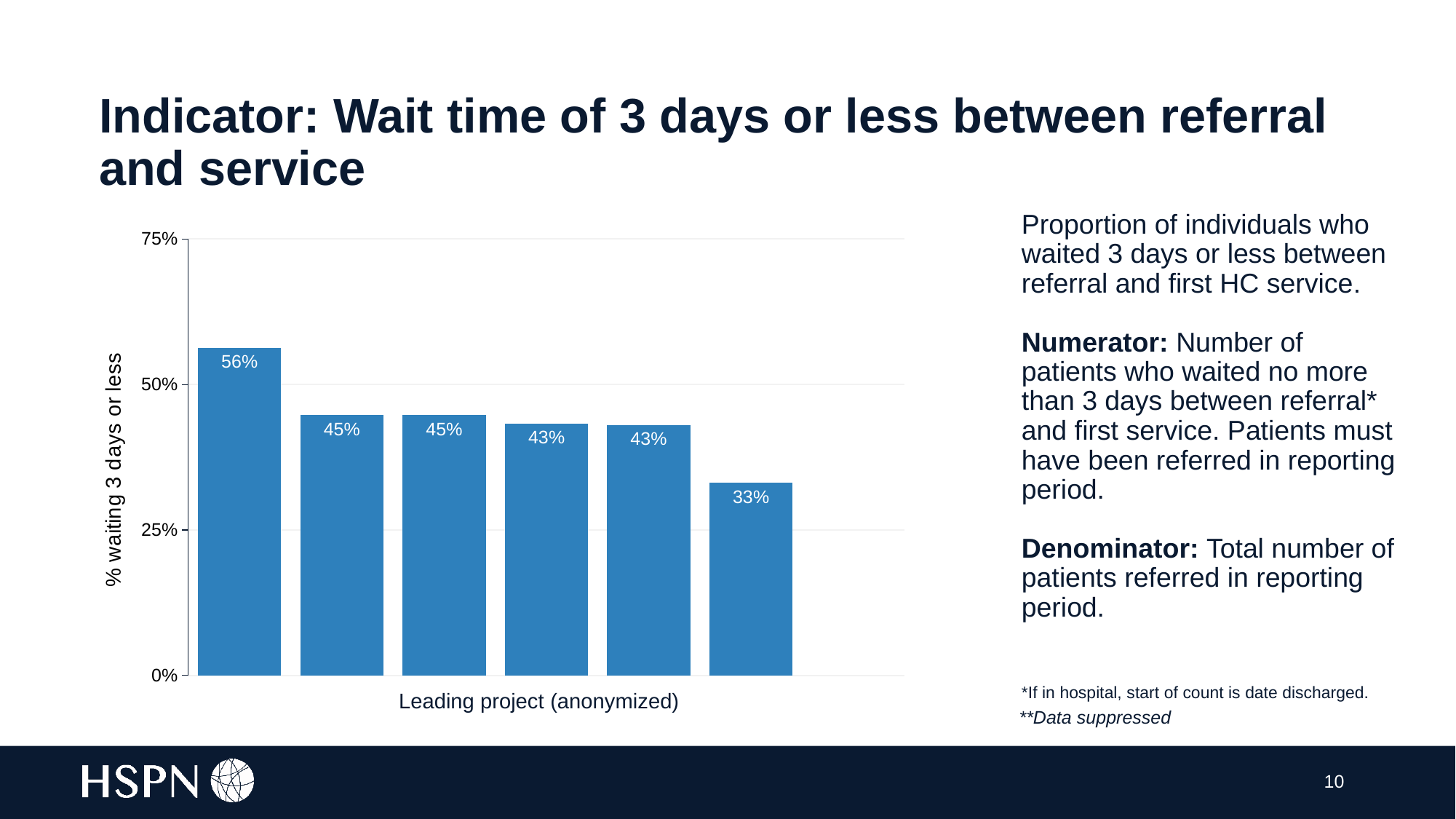
What is the value of the fourth bar from the left? 43% Do the bar values rise or fall from left to right across the chart? Fall What is the lowest value shown in the chart? 33% What is the value of the leftmost bar in the chart? 56% Is the value of the leftmost bar greater or less than 50%? greater What is the highest value shown in the chart? 56% What is the label on the vertical axis of the chart? % waiting 3 days or less What is the difference between the highest and lowest bar values in the chart? 23% How many bars (projects) are plotted in the chart? 6 What kind of chart is shown on the slide? Bar chart What is the label on the horizontal axis of the chart? Leading project (anonymized) What is the value of the rightmost bar in the chart? 33%